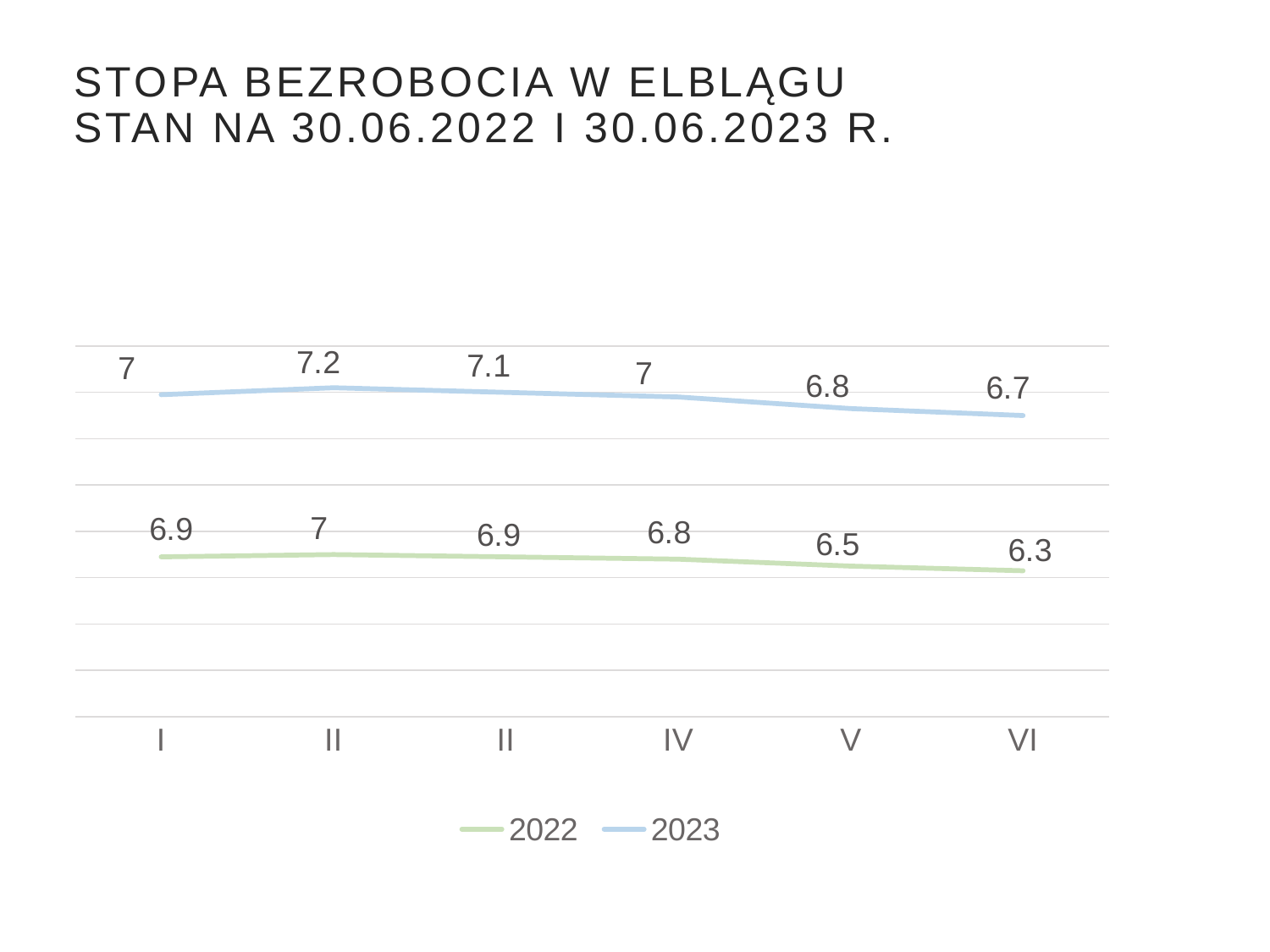
How many series does the legend list? 2 What kind of chart is shown on the slide? line chart What is the value of the 2022 series at IV? 6.8 What is the value of the 2023 series at I? 7 Does the 2022 series rise or fall from IV to VI? fall What is the highest value reached by the 2023 series? 7.2 At IV, which series has the higher value, 2022 or 2023? 2023 At which month does the 2022 series reach its lowest value? VI How many months are shown on the x axis? 6 What is the value of the 2022 series at V? 6.5 What is the difference between the 2023 and 2022 values at VI? 0.4 What is the value of the 2023 series at VI? 6.7